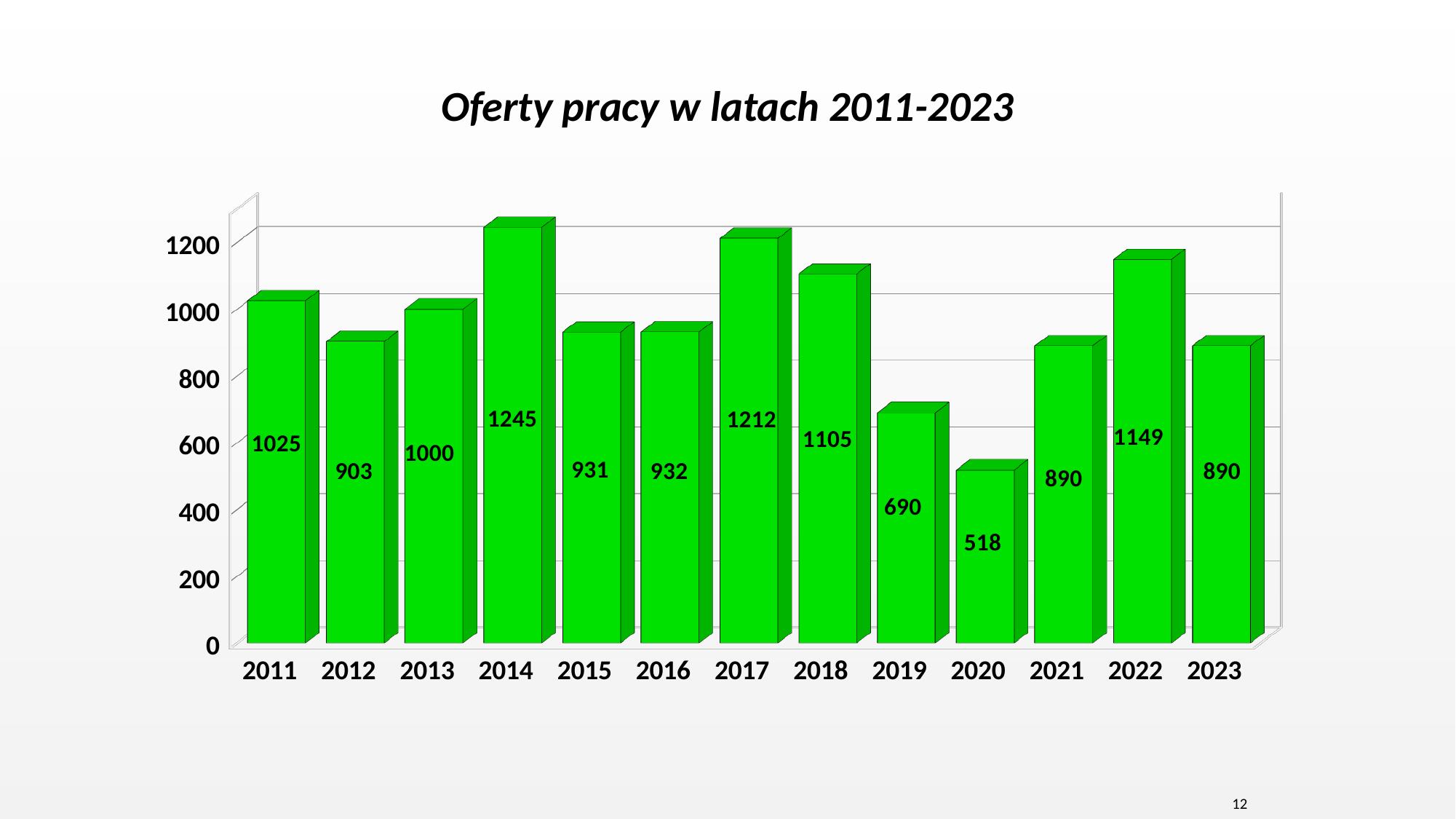
Which year has the highest value? 2014 How many years are shown on the x axis? 13 What is the difference between the values for 2022 and 2021? 259 What is the value for 2014? 1245 Which year has the lowest value? 2020 What is the value for 2020? 518 Which is larger, the value for 2017 or the value for 2018? 2017 What is the value for 2018? 1105 Is the value for 2019 greater or less than 800? less What kind of chart is shown on the slide? bar chart What is the difference between the values for 2014 and 2020? 727 What is the title of the chart? Oferty pracy w latach 2011-2023